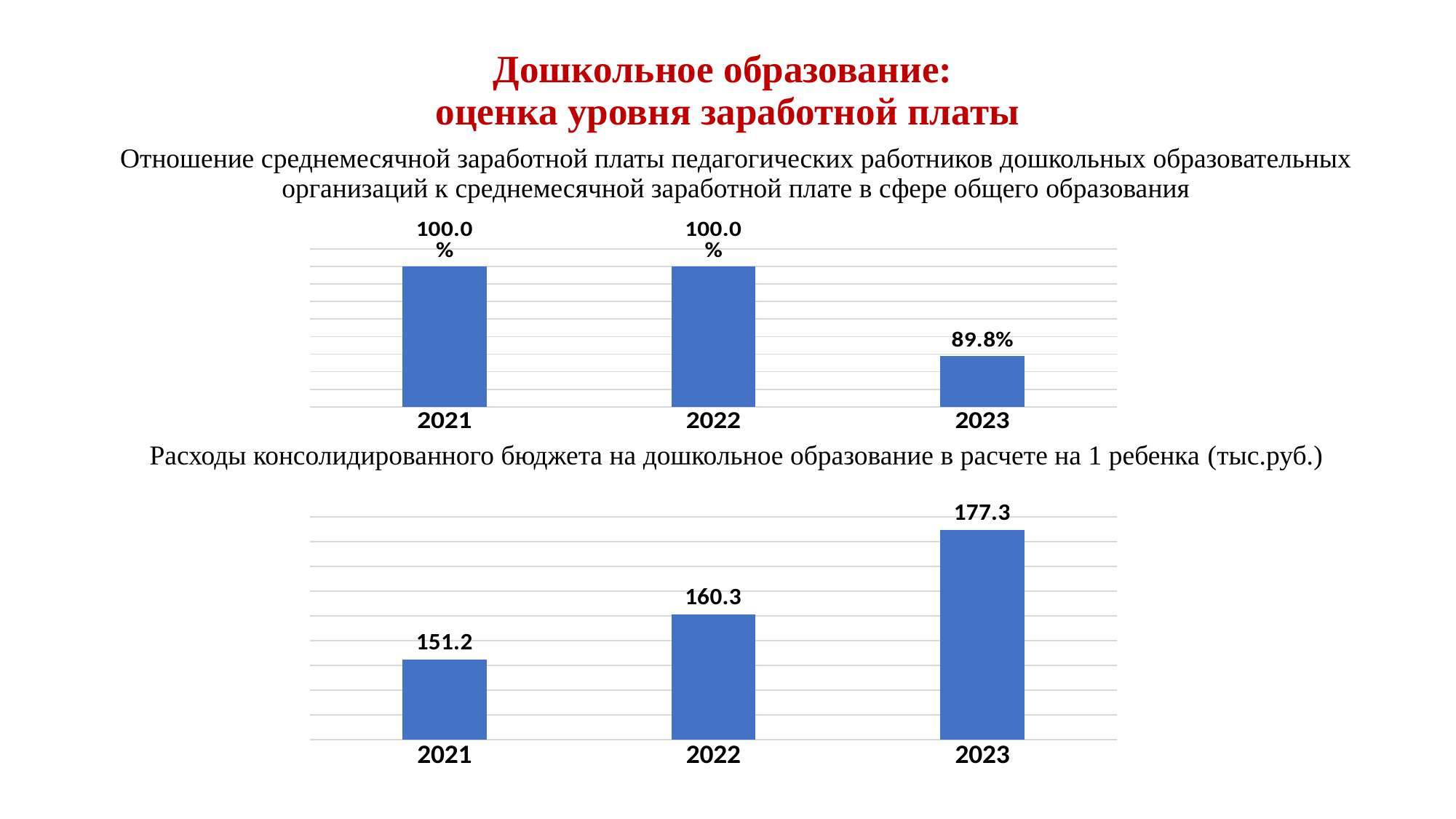
What type of chart is the bottom chart? bar chart In the bottom chart, what is the value for 2021? 151.2 In the top chart, what is the difference between the values for 2022 and 2023? 10.2% In the bottom chart, what is the value for 2022? 160.3 In the bottom chart, which year has the highest value? 2023 In the top chart, how many years are shown on the x axis? 3 In the top chart, what is the value for 2021? 100.0% In the bottom chart, what is the difference between the values for 2023 and 2021? 26.1 In the top chart, what is the value for 2023? 89.8% In the bottom chart, do the values rise or fall from 2021 to 2023? rise In the bottom chart, is the value for 2023 larger or smaller than the value for 2022? larger In the top chart, which year has the lowest value? 2023